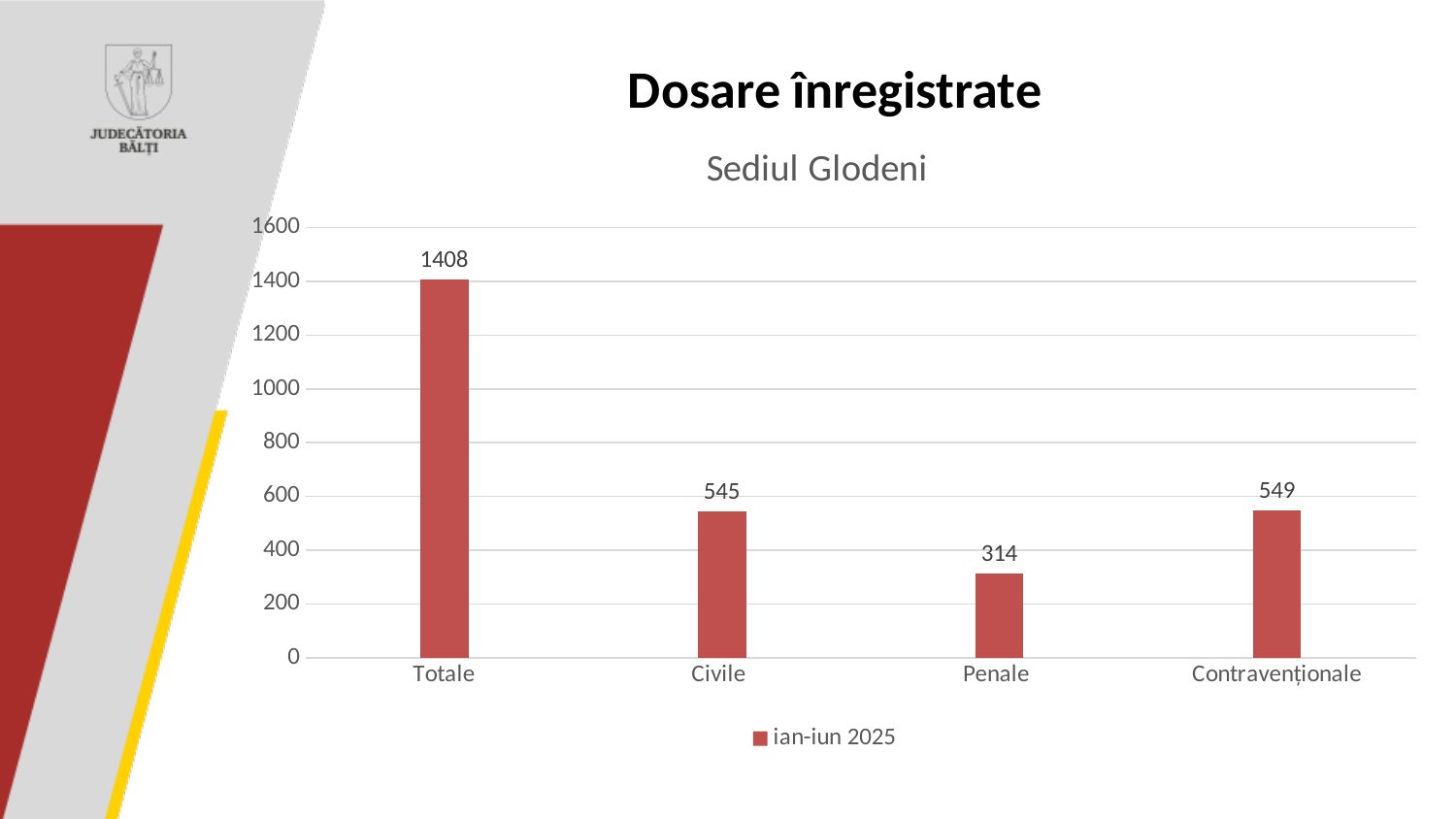
How many categories are shown on the x axis? 4 What series does the legend list? ian-iun 2025 What is the value for Contravenționale? 549 What is the difference between the values for Civile and Penale? 231 What is the difference between the values for Contravenționale and Civile? 4 Which category has the lowest value? Penale What is the value for Civile? 545 What is the value for Totale? 1408 What kind of chart is shown on the slide? bar chart What is the value for Penale? 314 Which is larger, the value for Civile or the value for Penale? Civile Which category has the highest value? Totale